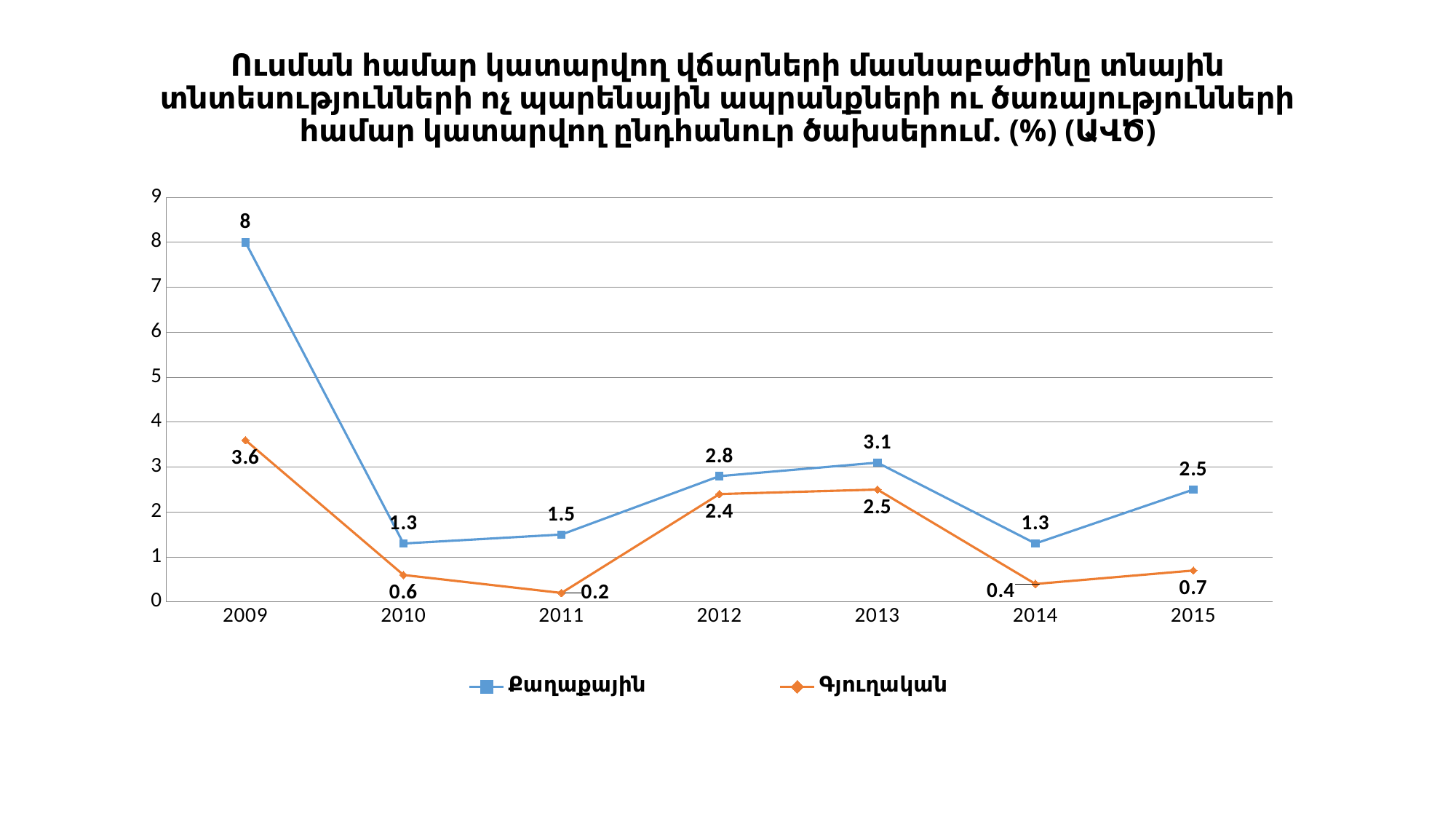
Which series has the larger value in 2014, Քաղաքային or Գյուղական? Քաղաքային What is the difference between the Քաղաքային and Գյուղական values in 2012? 0.4 What kind of chart is shown on the slide? Line chart In which year is the Քաղաքային series highest? 2009 How many series does the legend list? 2 In which year is the Գյուղական series lowest? 2011 What is the value for Գյուղական in 2013? 2.5 What is the value for Գյուղական in 2011? 0.2 What is the value for Քաղաքային in 2015? 2.5 How many years are shown on the x axis? 7 What is the value for Քաղաքային in 2009? 8 Does the Քաղաքային series rise or fall from 2009 to 2010? Fall